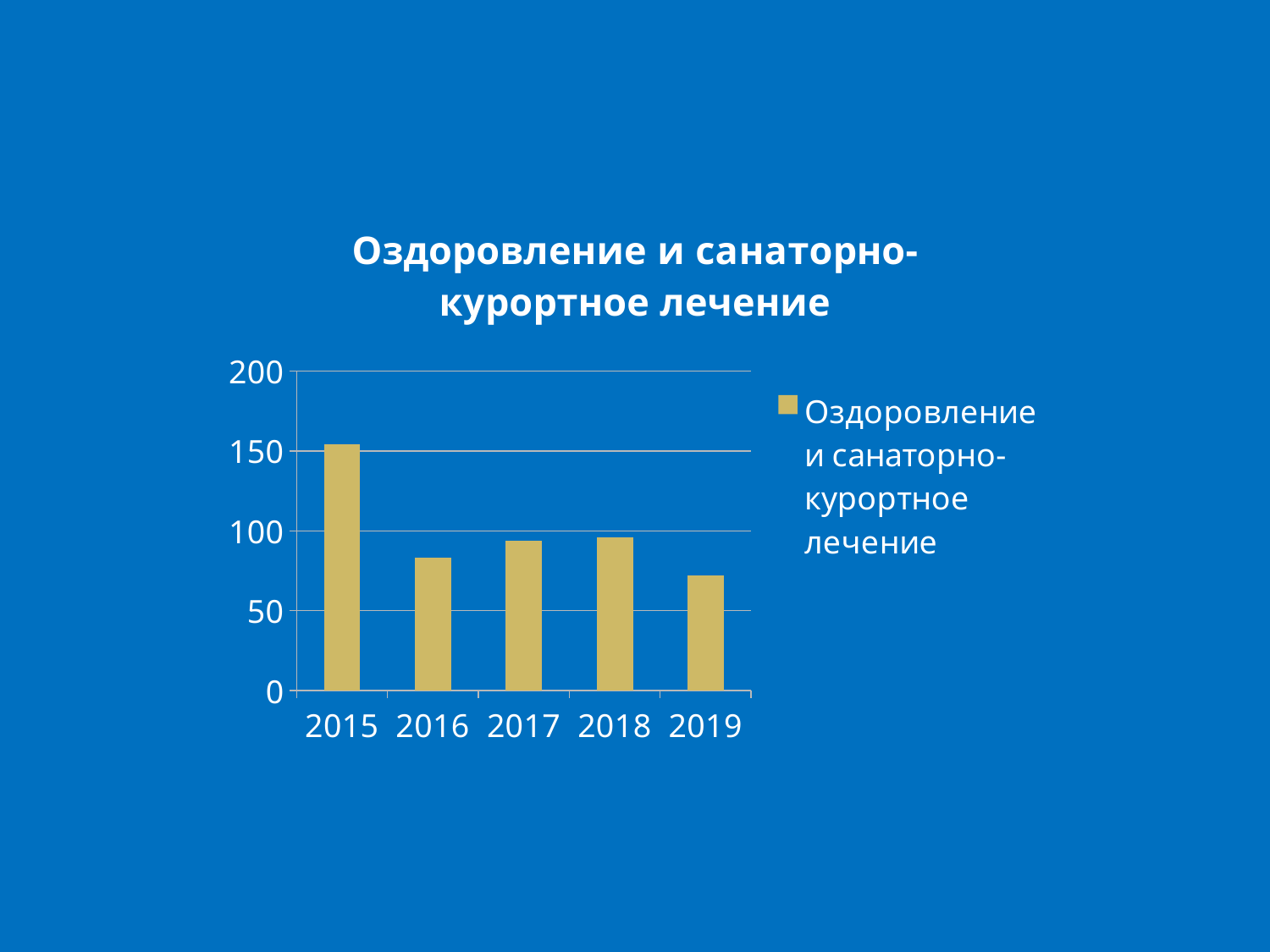
Which year has the highest value in the chart? 2015 How many series does the legend list? 1 How many years are shown on the x axis of the chart? 5 Which year has the lowest value in the chart? 2019 Is the value for 2016 greater or less than 100? less What kind of chart is shown on the slide? bar chart What is the title of the chart? Оздоровление и санаторно-курортное лечение Which year has the larger value, 2016 or 2019? 2016 Is the value for 2015 greater or less than 150? greater Is the value for 2019 greater or less than 50? greater Which year has the larger value, 2015 or 2016? 2015